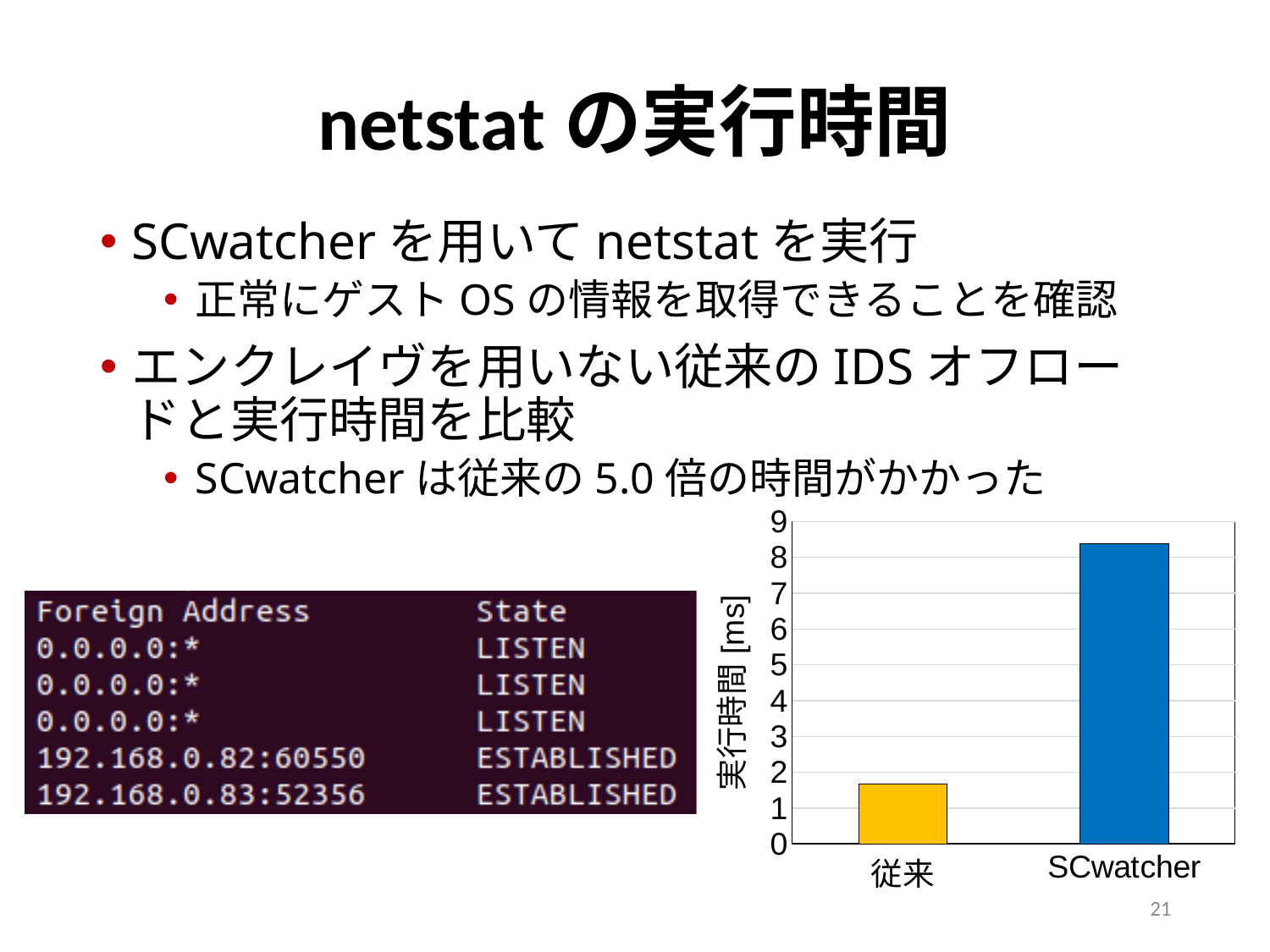
What is the highest tick value shown on the y axis of the bar chart? 9 What is the label of the y axis of the bar chart? 実行時間 [ms] Which category has the lowest execution time in the bar chart? 従来 Is the value for 従来 greater or less than 1? greater Is the value for SCwatcher greater or less than 9? less Is the value for SCwatcher greater or less than 8? greater What kind of chart is shown on the slide? bar chart How many categories are plotted in the bar chart? 2 Which category has the highest execution time in the bar chart? SCwatcher Which has a larger value in the bar chart, 従来 or SCwatcher? SCwatcher Do the bar values rise or fall from 従来 to SCwatcher? rise